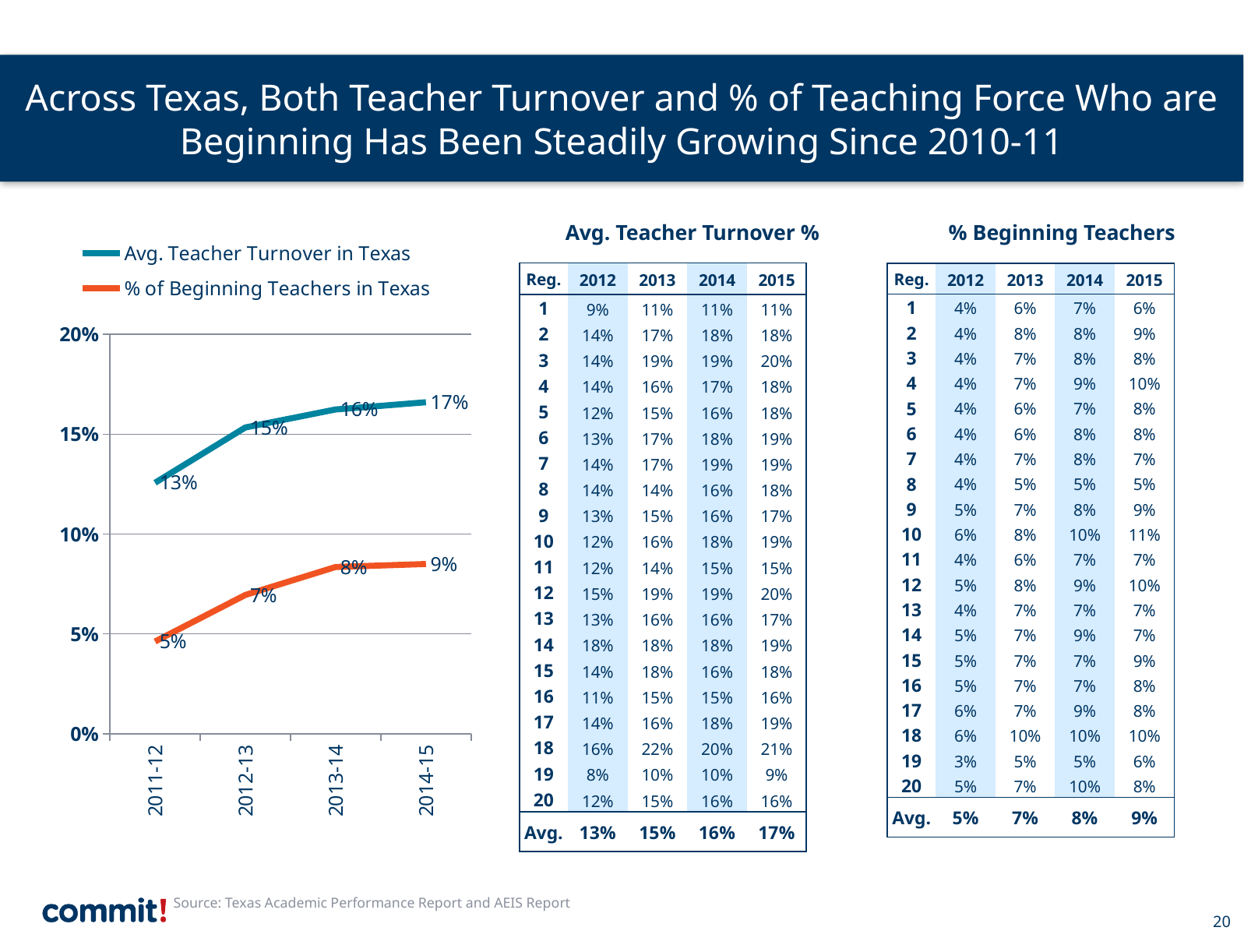
What type of chart is shown on the slide? Line chart Do the Avg. Teacher Turnover in Texas values rise or fall from 2011-12 to 2014-15? Rise What is the Avg. Teacher Turnover in Texas value for 2013-14? 16% What is the difference between the Avg. Teacher Turnover in Texas in 2014-15 and in 2011-12? 4% In which school year is the % of Beginning Teachers in Texas lowest? 2011-12 How many school years are plotted along the x axis of the chart? 4 What is the Avg. Teacher Turnover in Texas value for 2011-12? 13% How many series does the chart legend list? 2 Which colour is used for the % of Beginning Teachers in Texas line? Orange In which school year is the Avg. Teacher Turnover in Texas highest? 2014-15 What is the % of Beginning Teachers in Texas value for 2014-15? 9% Which is larger in 2012-13: Avg. Teacher Turnover in Texas or % of Beginning Teachers in Texas? Avg. Teacher Turnover in Texas